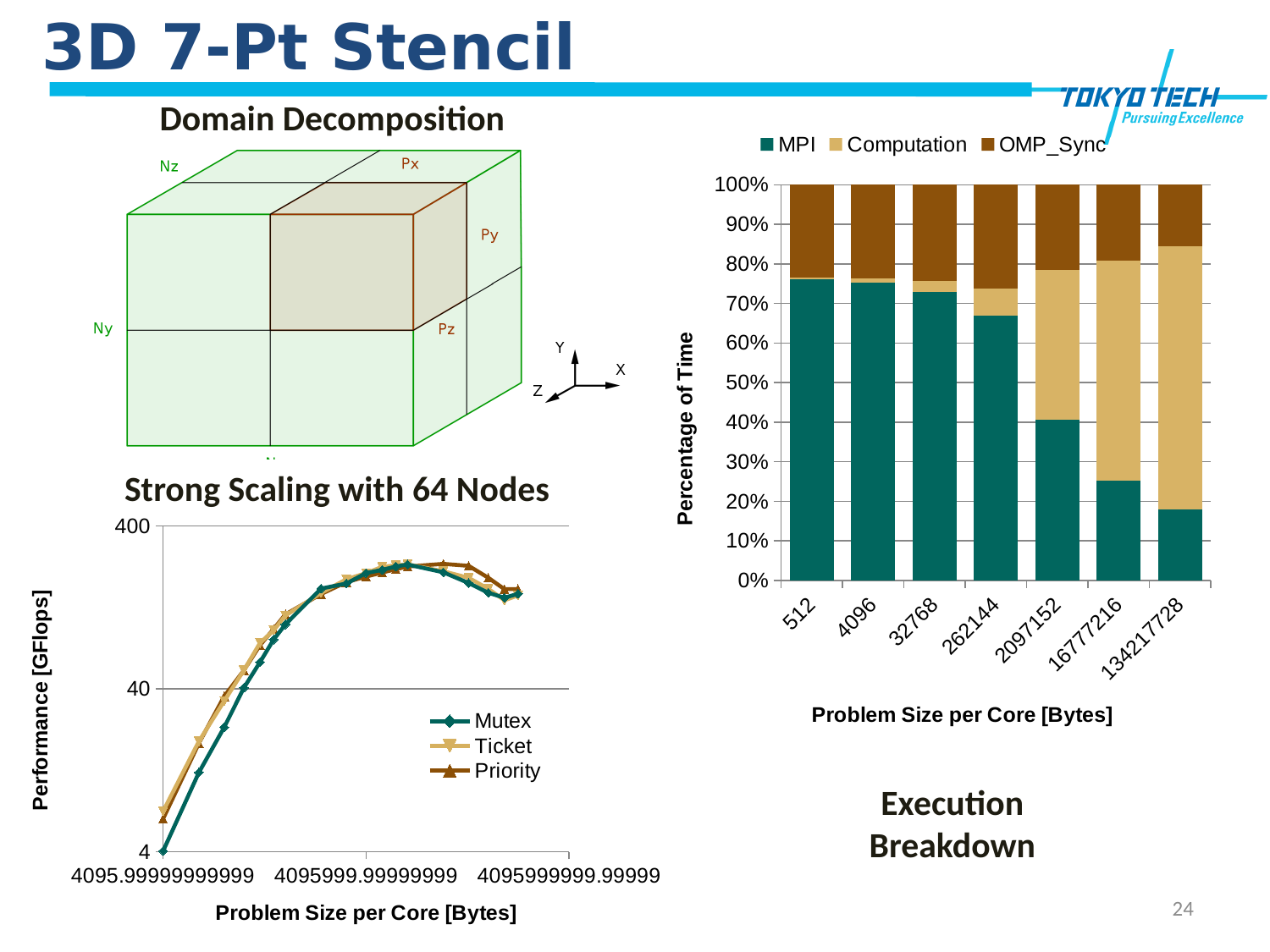
In the Execution Breakdown chart, what is the total height of the stacked bar for problem size 512? 100% What kind of chart is the Strong Scaling with 64 Nodes chart? line chart How many series does the legend of the Strong Scaling with 64 Nodes chart list? 3 In the Execution Breakdown chart, which problem size has the smallest MPI share? 134217728 What is the y-axis label of the Strong Scaling with 64 Nodes chart? Performance [GFlops] In the Execution Breakdown chart, is the Computation share for problem size 512 greater or less than 10%? less In the Execution Breakdown chart, is the MPI share for problem size 134217728 greater or less than 20%? less In the Execution Breakdown chart, does the MPI share rise or fall as the problem size per core increases? fall How many problem-size categories are shown on the x axis of the Execution Breakdown chart? 7 How many series does the legend of the Execution Breakdown chart list? 3 In the Execution Breakdown chart, is the MPI share for problem size 512 greater or less than 70%? greater What kind of chart is the Execution Breakdown chart? stacked bar chart